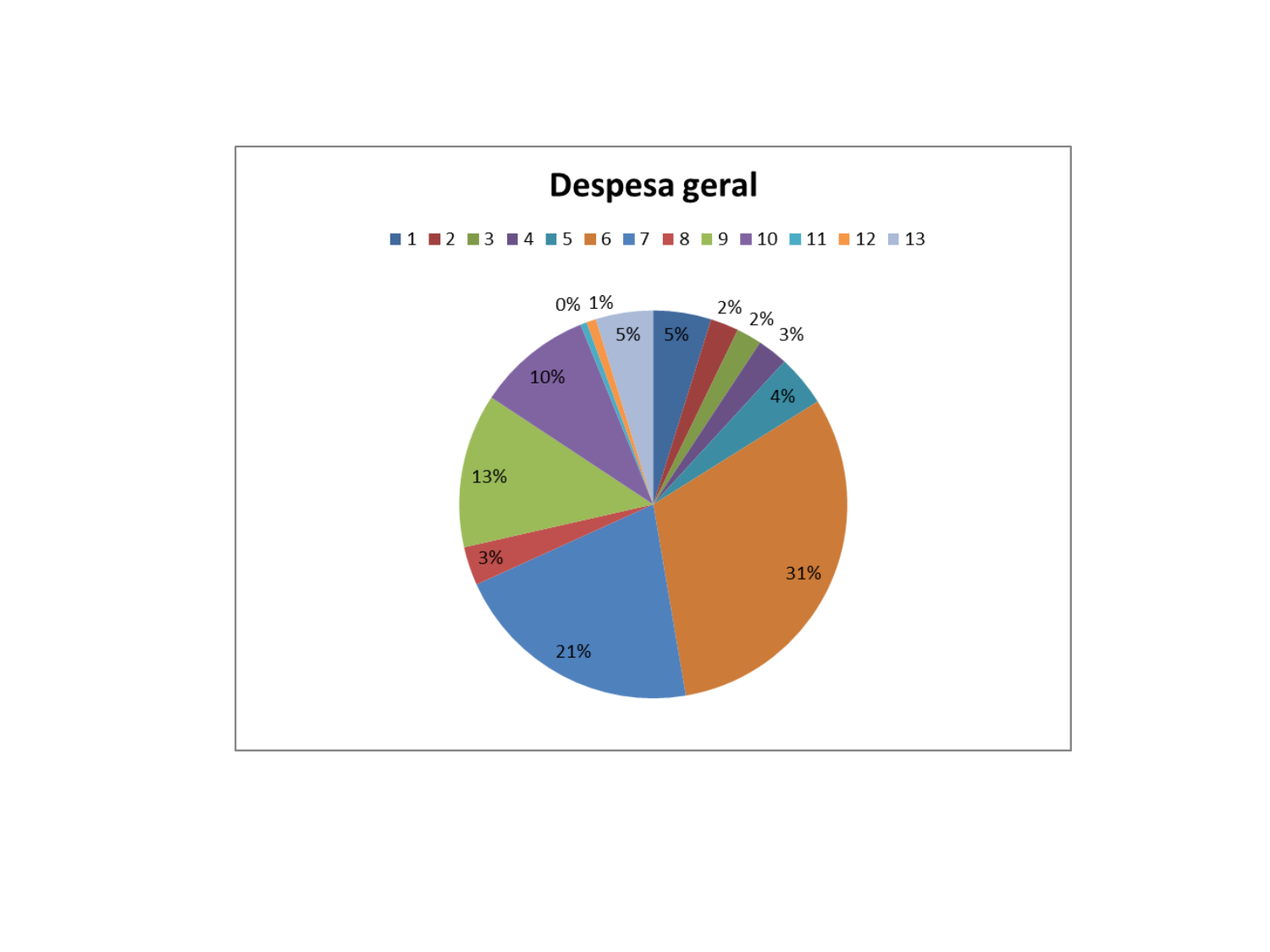
What share of the pie does category 9 have? 13% How many categories does the legend list? 13 What is the difference in percentage points between category 6 and category 7? 10 What share of the pie does category 1 have? 5% Which is larger, the slice for category 9 or the slice for category 10? 9 Which category has the largest slice of the pie? 6 What share of the pie does category 7 have? 21% Which category has the smallest slice of the pie? 11 What kind of chart is shown on the slide? pie chart What is the title of the chart? Despesa geral